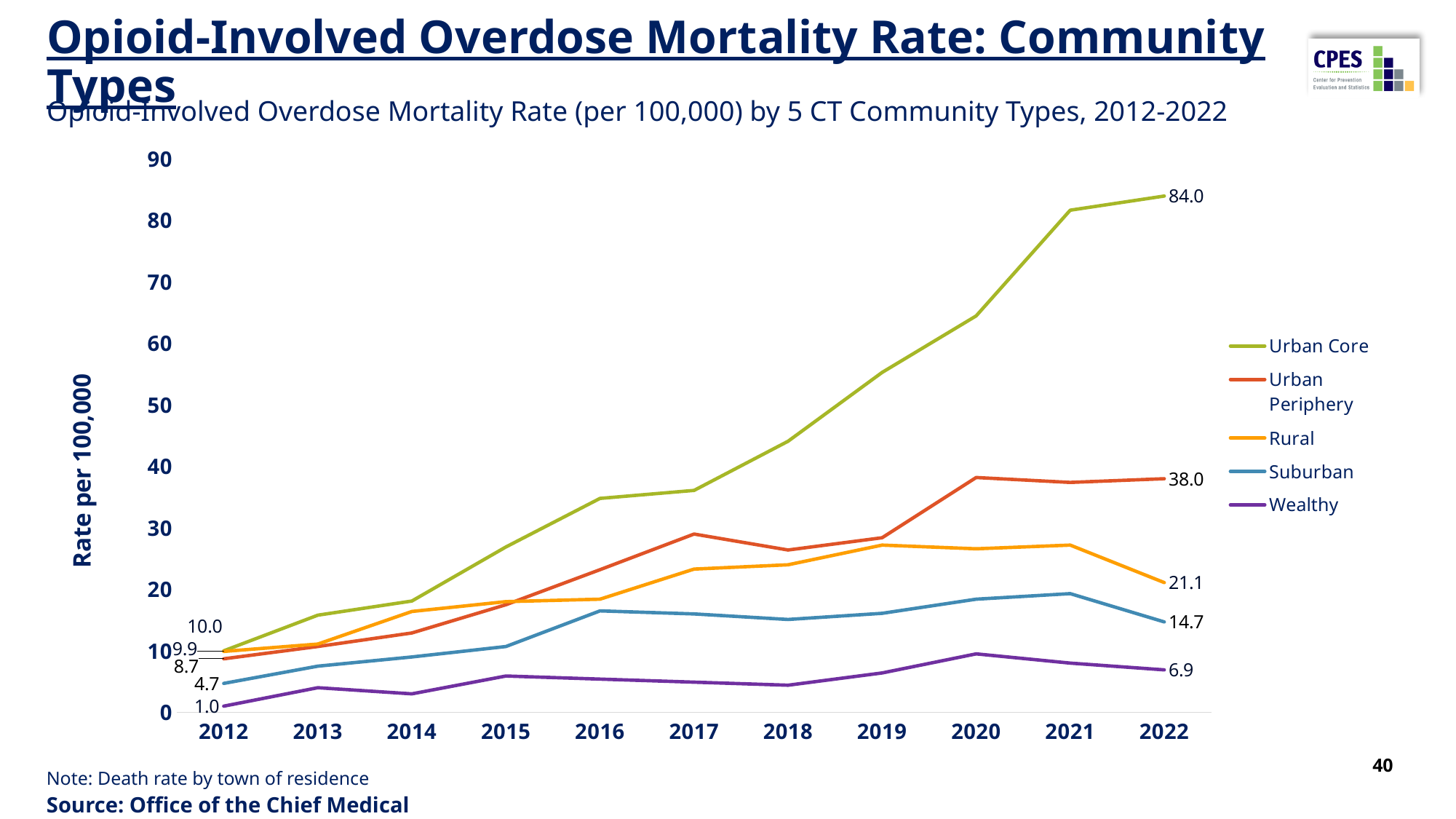
What type of chart is shown on the slide? line chart Which was higher in 2022, the Suburban rate or the Rural rate? Rural What was the Rural rate in 2022? 21.1 How many years are shown on the x axis? 11 Which community type had the highest mortality rate in 2022? Urban Core Which community type had the lowest mortality rate in 2022? Wealthy What was the Urban Periphery rate in 2022? 38.0 What is the difference between the Urban Core and Urban Periphery rates in 2022? 46.0 What was the Urban Core opioid-involved overdose mortality rate in 2022? 84.0 Is the Urban Core rate in 2020 greater or less than 60? greater How many series does the legend list? 5 What was the Wealthy community type rate in 2012? 1.0